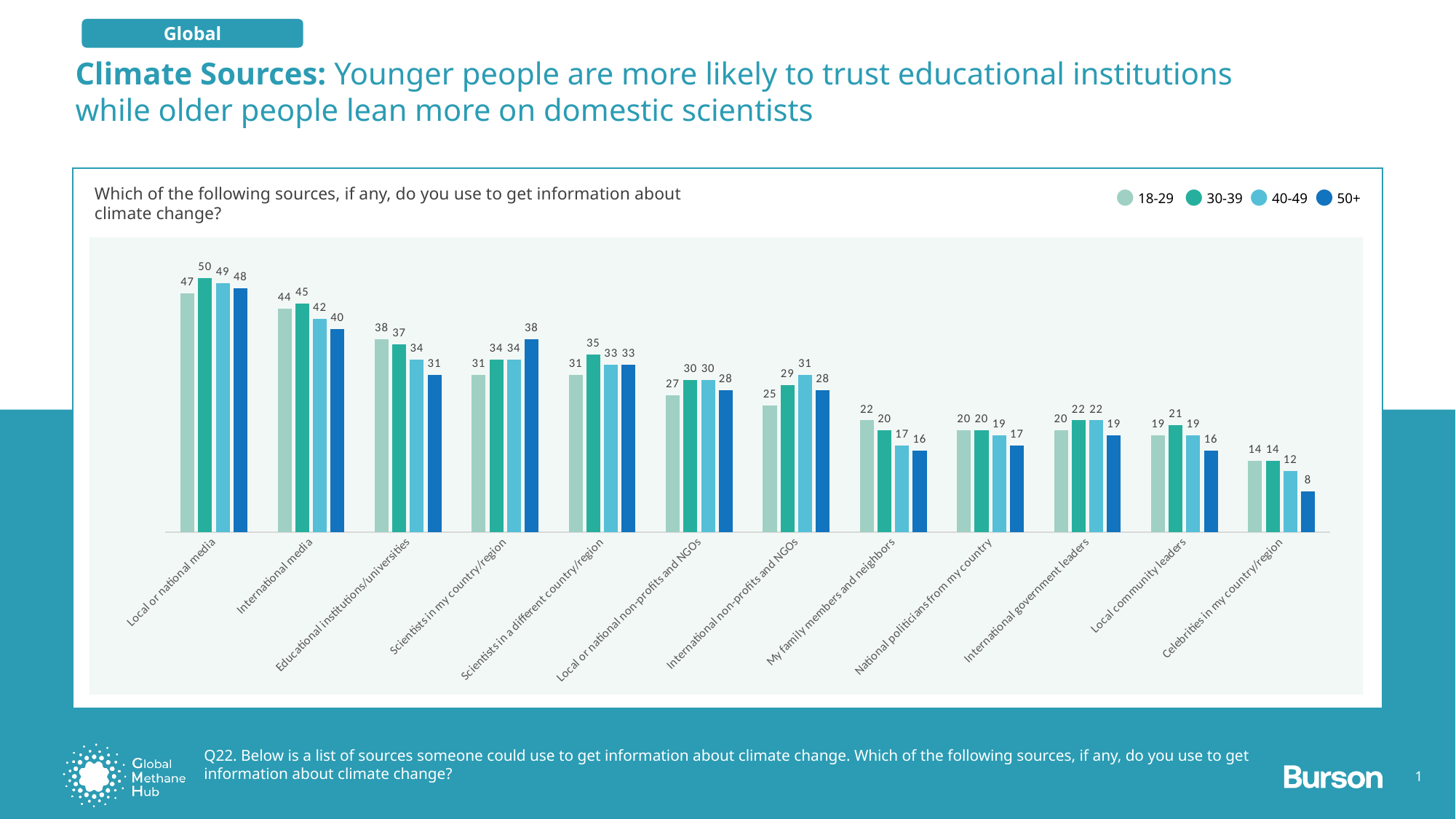
What is the difference between the 18-29 and 50+ values for Educational institutions/universities? 7 Do the values for the 50+ age group rise or fall from Local or national media to Celebrities in my country/region? fall Which age group has the highest value for Local or national media? 30-39 Which age group has the lowest value for Celebrities in my country/region? 50+ What is the value for the 50+ age group for Scientists in my country/region? 38 What is the value for the 18-29 age group for Educational institutions/universities? 38 Which age group is represented by the darkest blue bars in the legend? 50+ How many source categories are shown on the x axis? 12 How many series does the legend list? 4 What kind of chart is shown on the slide? bar chart What is the value for the 40-49 age group for International non-profits and NGOs? 31 Which is larger for International media: the 30-39 value or the 50+ value? 30-39